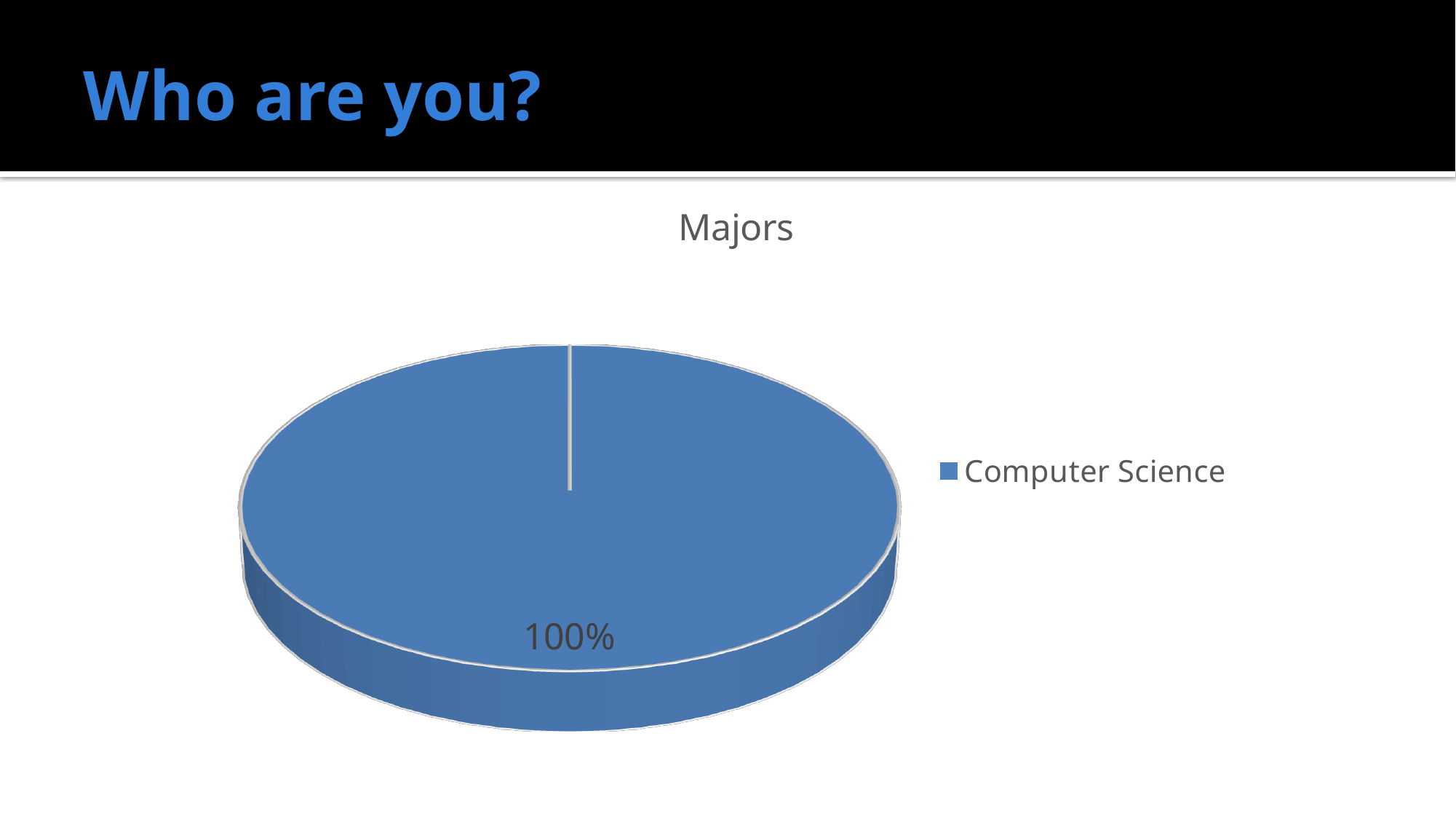
How many slices does the pie chart have? 1 What is the title of the chart? Majors What value is printed on the Computer Science slice? 100% Which category is shown in the legend? Computer Science What share of the pie does Computer Science take? 100% What kind of chart is shown on the slide? pie chart Which category has the largest share of the pie? Computer Science How many entries does the legend list? 1